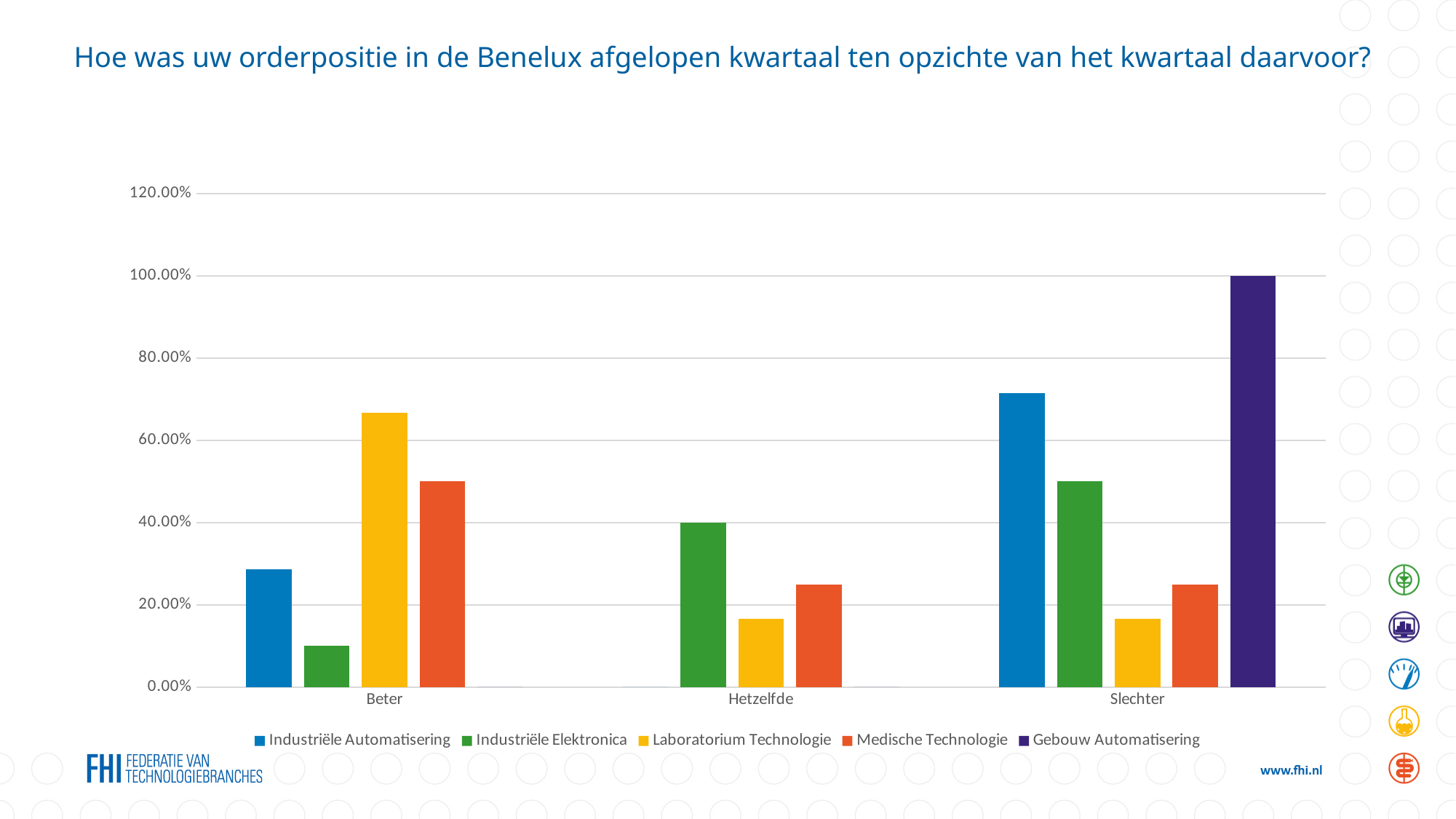
Is the value for Laboratorium Technologie in the Beter category greater or less than 60.00%? greater How many series does the legend list? 5 Which series has the highest value in the Slechter category? Gebouw Automatisering How many categories are shown on the x axis? 3 What is the value for Gebouw Automatisering in the Slechter category? 100.00% Which series has the highest value in the Beter category? Laboratorium Technologie What kind of chart is shown on the slide? bar chart Is the value for Laboratorium Technologie in the Hetzelfde category greater or less than 20.00%? less In the Beter category, which is larger: Industriële Automatisering or Industriële Elektronica? Industriële Automatisering What is the value for Industriële Elektronica in the Hetzelfde category? 40.00% Is the value for Industriële Automatisering in the Slechter category greater or less than 60.00%? greater